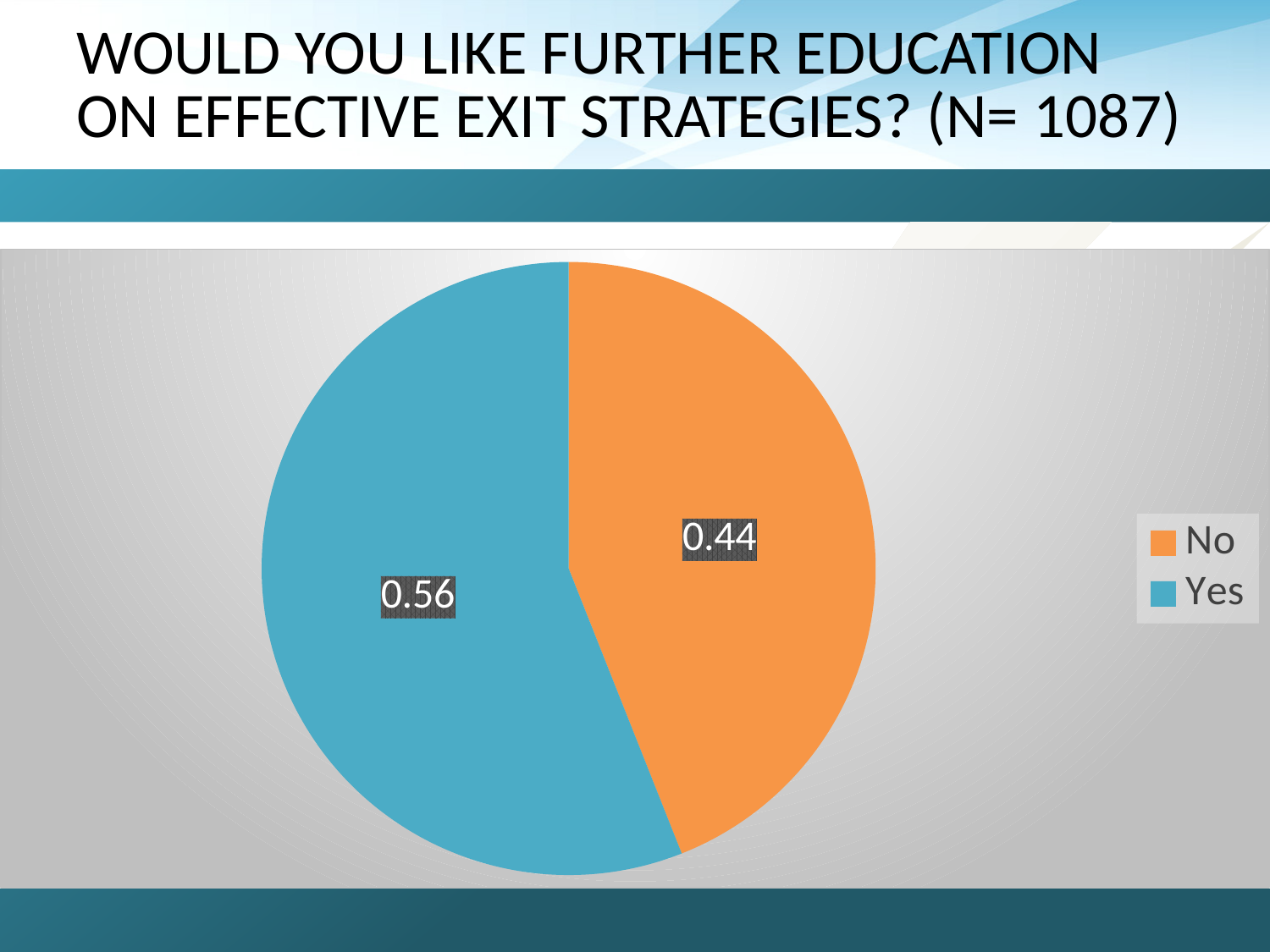
What colour is the Yes slice? blue What colour is the No slice? orange What kind of chart is shown on the slide? pie chart How many slices does the pie chart have? 2 What is the value for the Yes slice? 0.56 What is the sample size (N) given in the slide title? 1087 Which slice is the smallest? No What is the value for the No slice? 0.44 Which slice is the largest? Yes Which is larger, the Yes slice or the No slice? Yes What is the difference between the Yes and No values? 0.12 How many entries does the legend list? 2